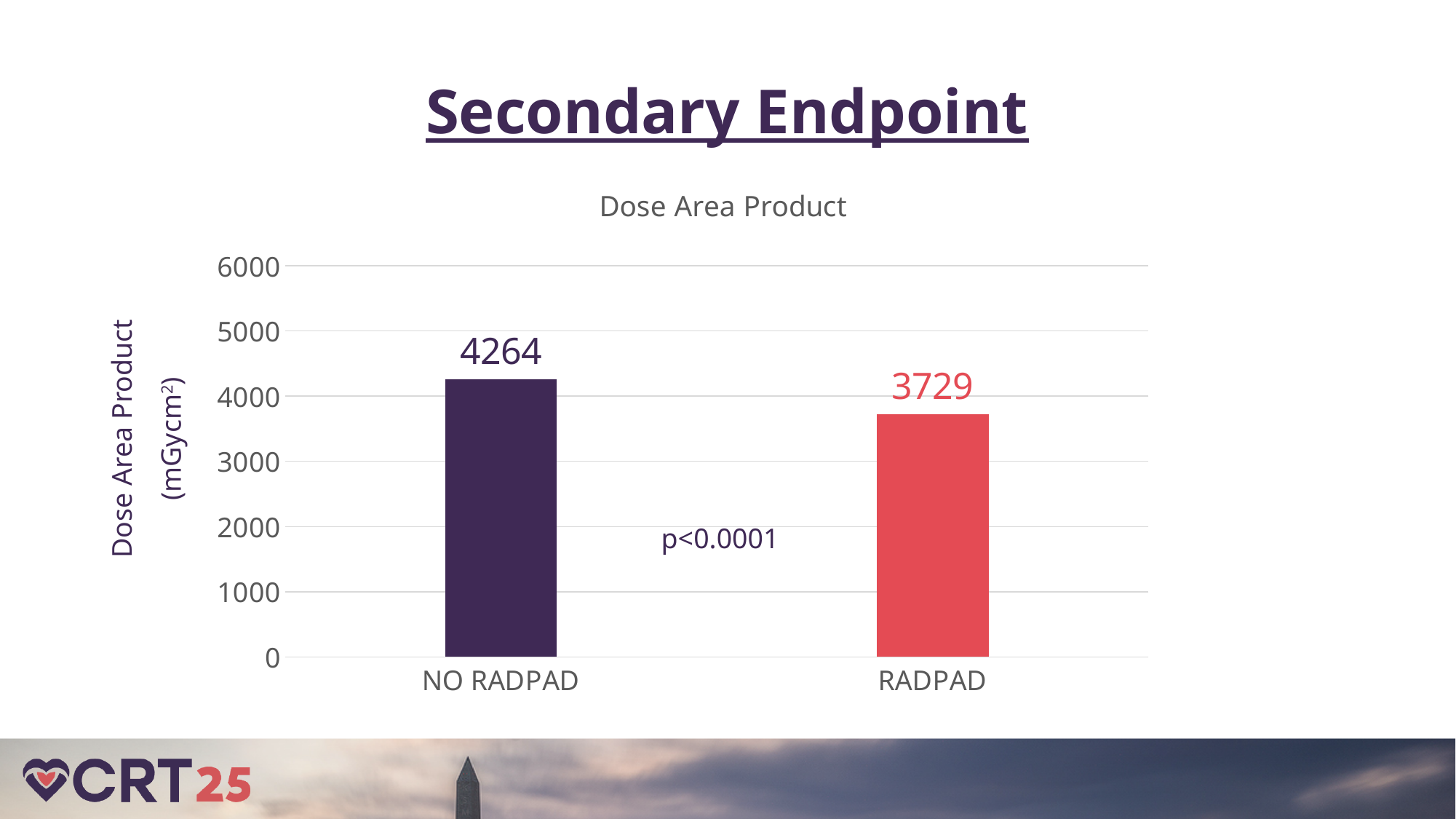
What is the difference between the NO RADPAD and RADPAD values? 535 What is the title of the chart? Dose Area Product Is the value for RADPAD greater or less than 4000? less Which category has the higher Dose Area Product? NO RADPAD Is the value for RADPAD larger or smaller than the value for NO RADPAD? smaller Which category has the lower Dose Area Product? RADPAD Is the value for NO RADPAD greater or less than 4000? greater What is the Dose Area Product value for NO RADPAD? 4264 How many categories are shown on the x axis? 2 What p-value is printed on the chart? p<0.0001 What kind of chart is shown on the slide? bar chart What is the Dose Area Product value for RADPAD? 3729